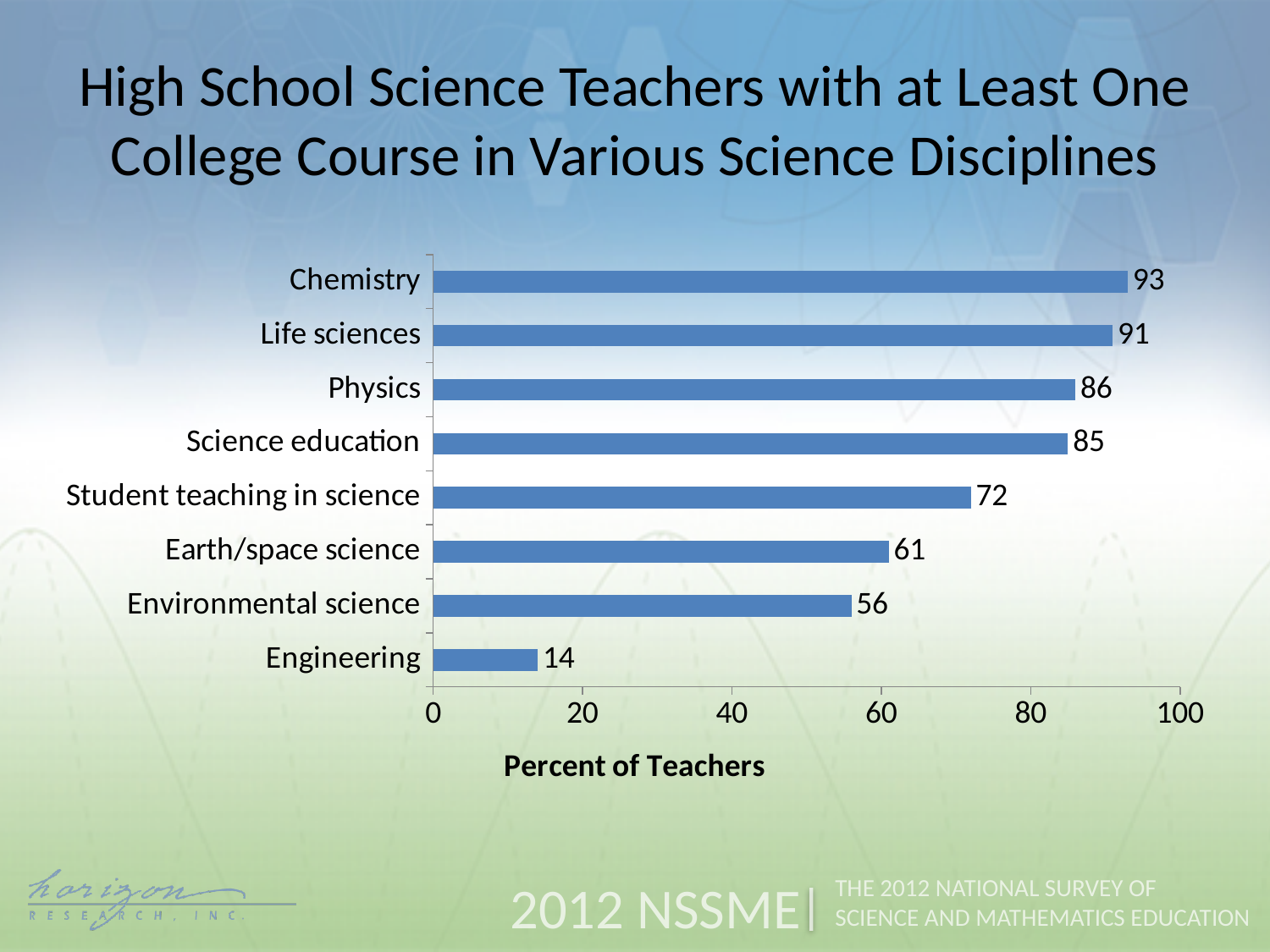
What percent of high school science teachers have at least one college course in Chemistry? 93 Which is larger, the value for Physics or the value for Earth/space science? Physics Which discipline has the lowest percent of teachers? Engineering What is the value shown for Student teaching in science? 72 What is the difference between the values for Chemistry and Engineering? 79 Is the value for Environmental science greater or less than 60? less What is the difference between the values for Earth/space science and Environmental science? 5 What is the value shown for Engineering? 14 Which discipline has the highest percent of teachers? Chemistry What kind of chart is shown on the slide? bar chart How many disciplines are shown in the chart? 8 What is the label of the horizontal axis? Percent of Teachers